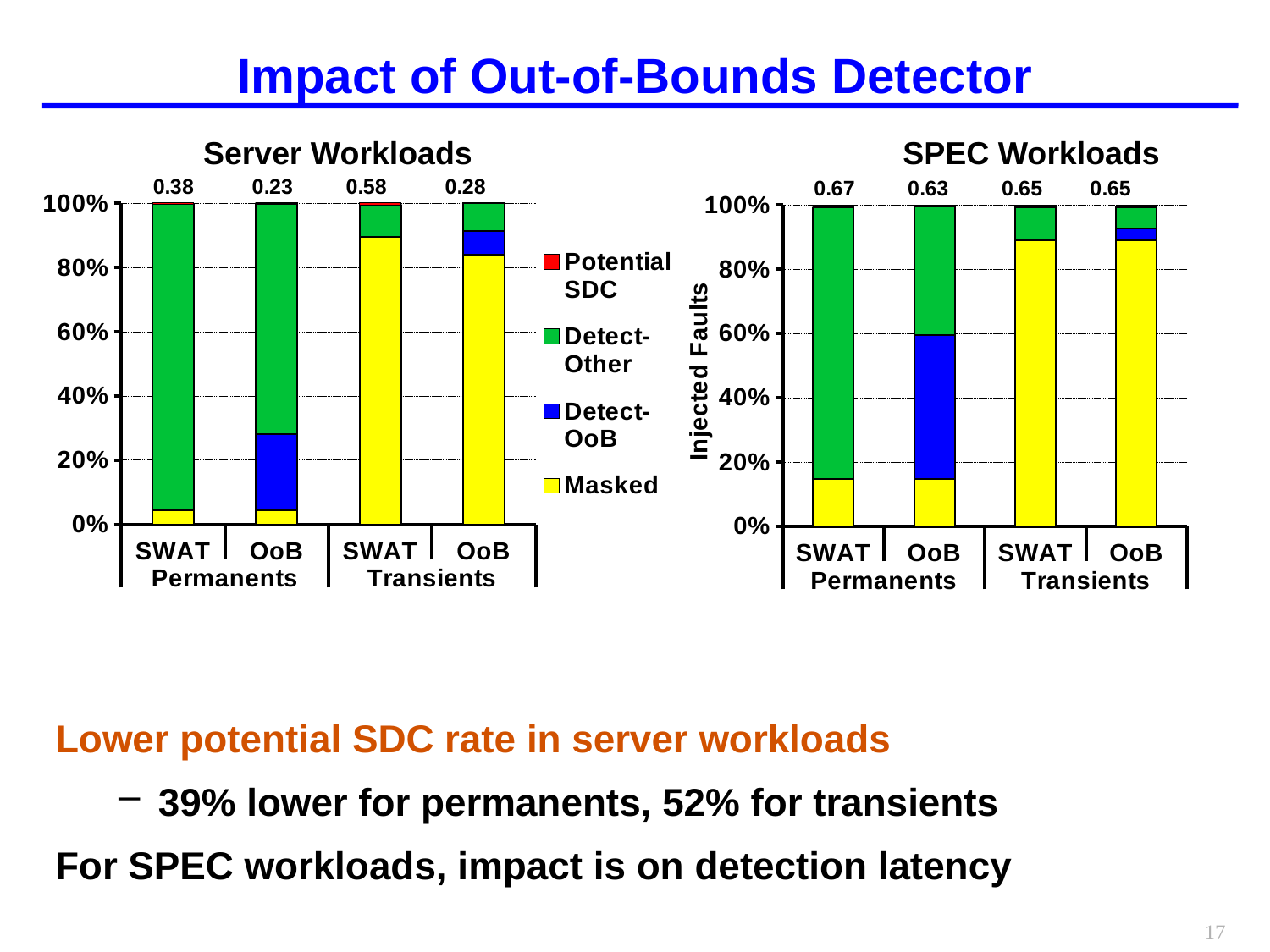
In the Server Workloads chart, what value is printed above the OoB Transients bar? 0.28 What kind of chart is the Server Workloads chart? Stacked bar chart In the Server Workloads chart, which bar has the highest printed value above it? SWAT Transients In the Server Workloads chart, what is the difference between the printed values above the SWAT Transients and OoB Transients bars? 0.30 In the Server Workloads chart, is the Masked share of the SWAT Transients bar greater or less than 80%? greater In the SPEC Workloads chart, is the Masked share of the SWAT Permanents bar greater or less than 20%? less How many series does the legend list for the charts? 4 In the Server Workloads chart, what value is printed above the SWAT Permanents bar? 0.38 In the SPEC Workloads chart, what value is printed above the OoB Permanents bar? 0.63 In the SPEC Workloads chart, which bar has the highest printed value above it? SWAT Permanents In the Server Workloads chart, which bar has the lowest printed value above it? OoB Permanents How many bars does the SPEC Workloads chart show? 4